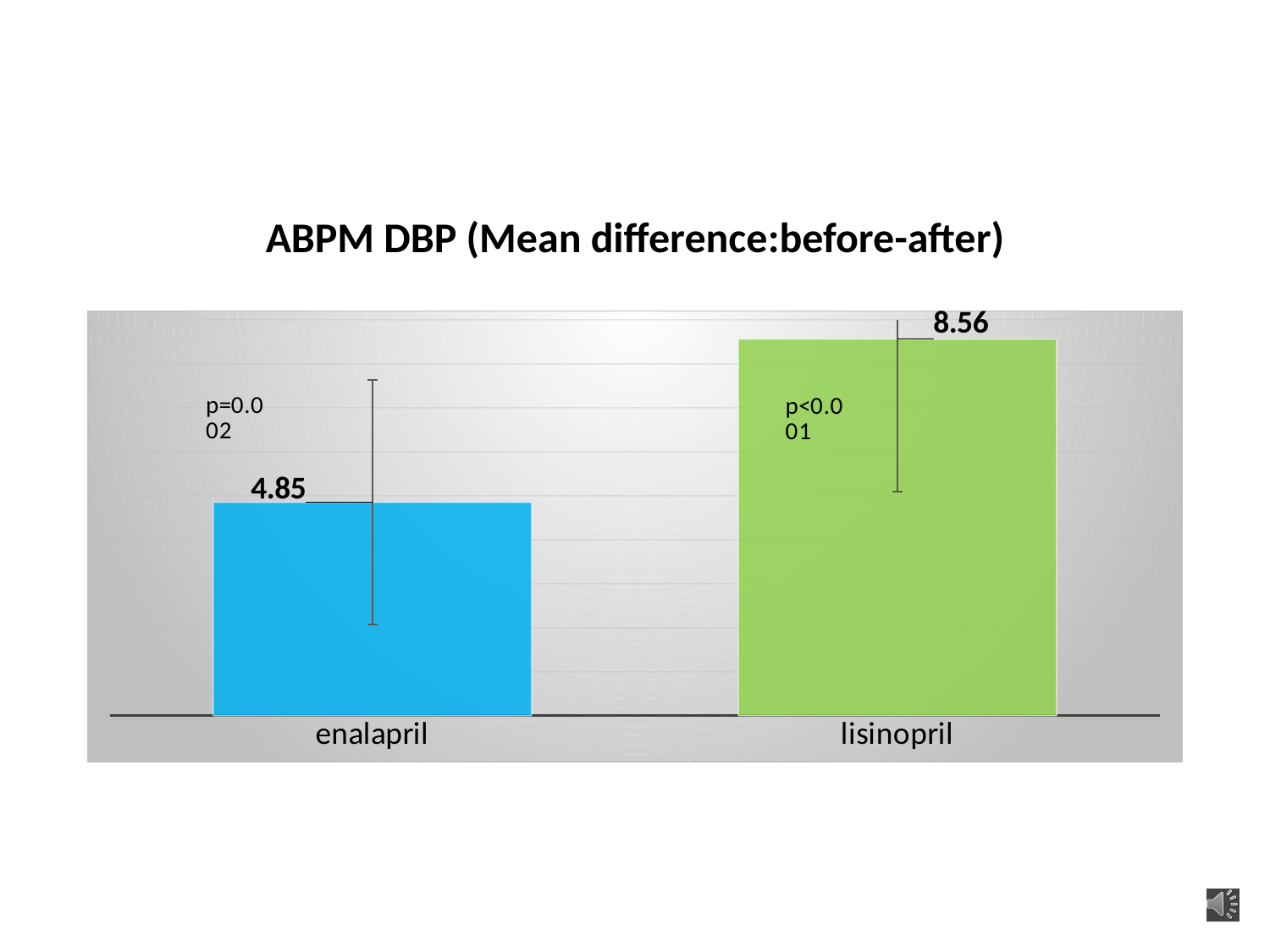
What is the value for enalapril? 4.85 Which category has the highest value? lisinopril What is the value for lisinopril? 8.56 What p-value is shown for the enalapril bar? p=0.002 What colour is the bar for lisinopril? green What is the difference between the values for lisinopril and enalapril? 3.71 What is the title of the chart? ABPM DBP (Mean difference:before-after) Which is larger, the value for enalapril or the value for lisinopril? lisinopril What kind of chart is shown on the slide? bar chart What p-value is shown for the lisinopril bar? p<0.001 How many categories are shown on the chart? 2 Which category has the lowest value? enalapril